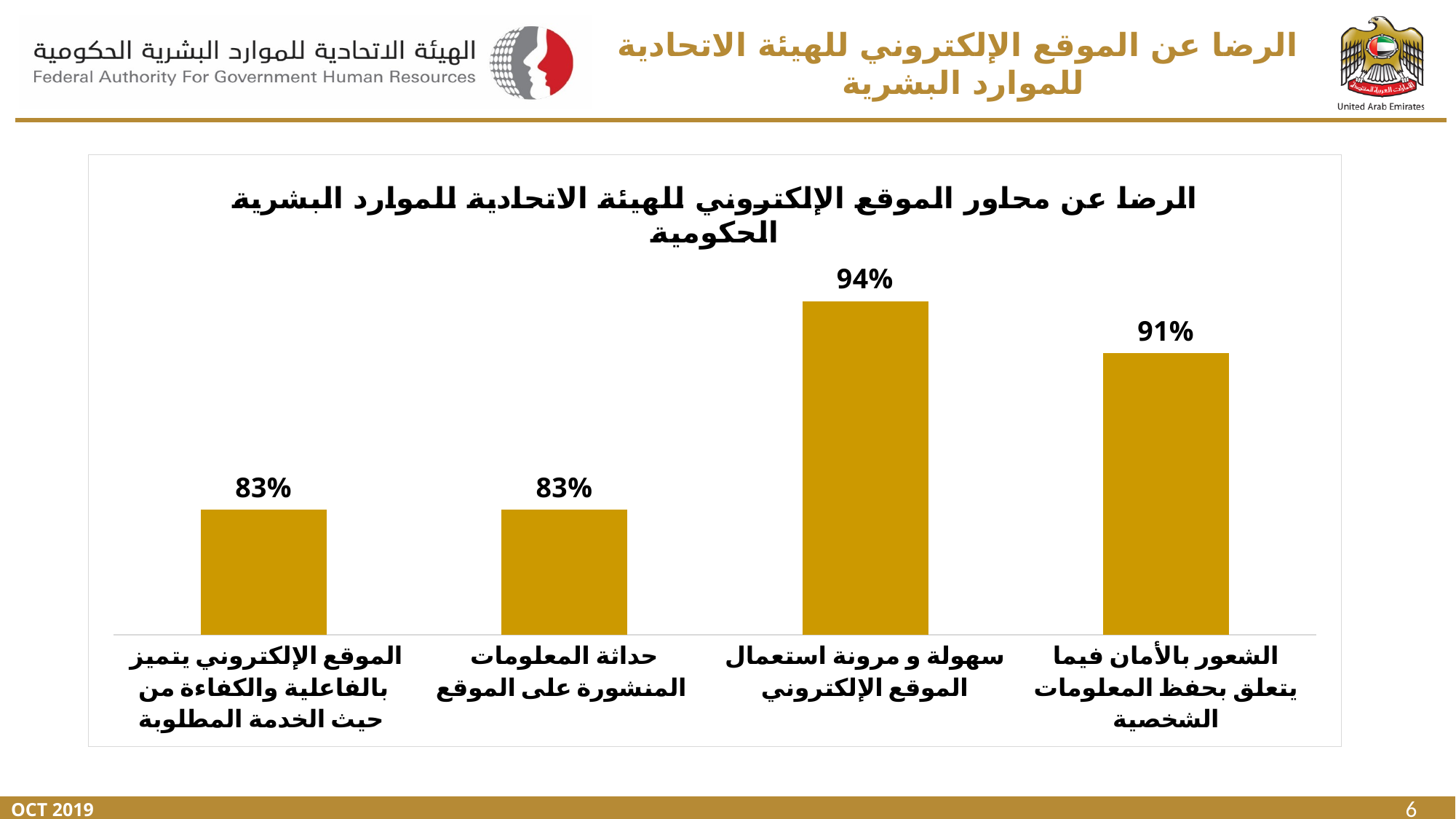
What type of chart is shown on the slide? Bar chart What is the difference between the values for "سهولة و مرونة استعمال الموقع الإلكتروني" and "الشعور بالأمان فيما يتعلق بحفظ المعلومات الشخصية"? 3% What is the satisfaction value for "حداثة المعلومات المنشورة على الموقع"? 83% What is the satisfaction value for "سهولة و مرونة استعمال الموقع الإلكتروني"? 94% What is the satisfaction value for "الموقع الإلكتروني يتميز بالفاعلية والكفاءة من حيث الخدمة المطلوبة"? 83% What is the satisfaction value for "الشعور بالأمان فيما يتعلق بحفظ المعلومات الشخصية"? 91% Which category has the highest satisfaction value? سهولة و مرونة استعمال الموقع الإلكتروني What is the difference between the values for "سهولة و مرونة استعمال الموقع الإلكتروني" and "حداثة المعلومات المنشورة على الموقع"? 11% What colour are the bars in the chart? Gold What is the title of the chart? الرضا عن محاور الموقع الإلكتروني للهيئة الاتحادية للموارد البشرية الحكومية How many categories (bars) does the chart show? 4 Which is larger: the value for "الشعور بالأمان فيما يتعلق بحفظ المعلومات الشخصية" or the value for "حداثة المعلومات المنشورة على الموقع"? الشعور بالأمان فيما يتعلق بحفظ المعلومات الشخصية